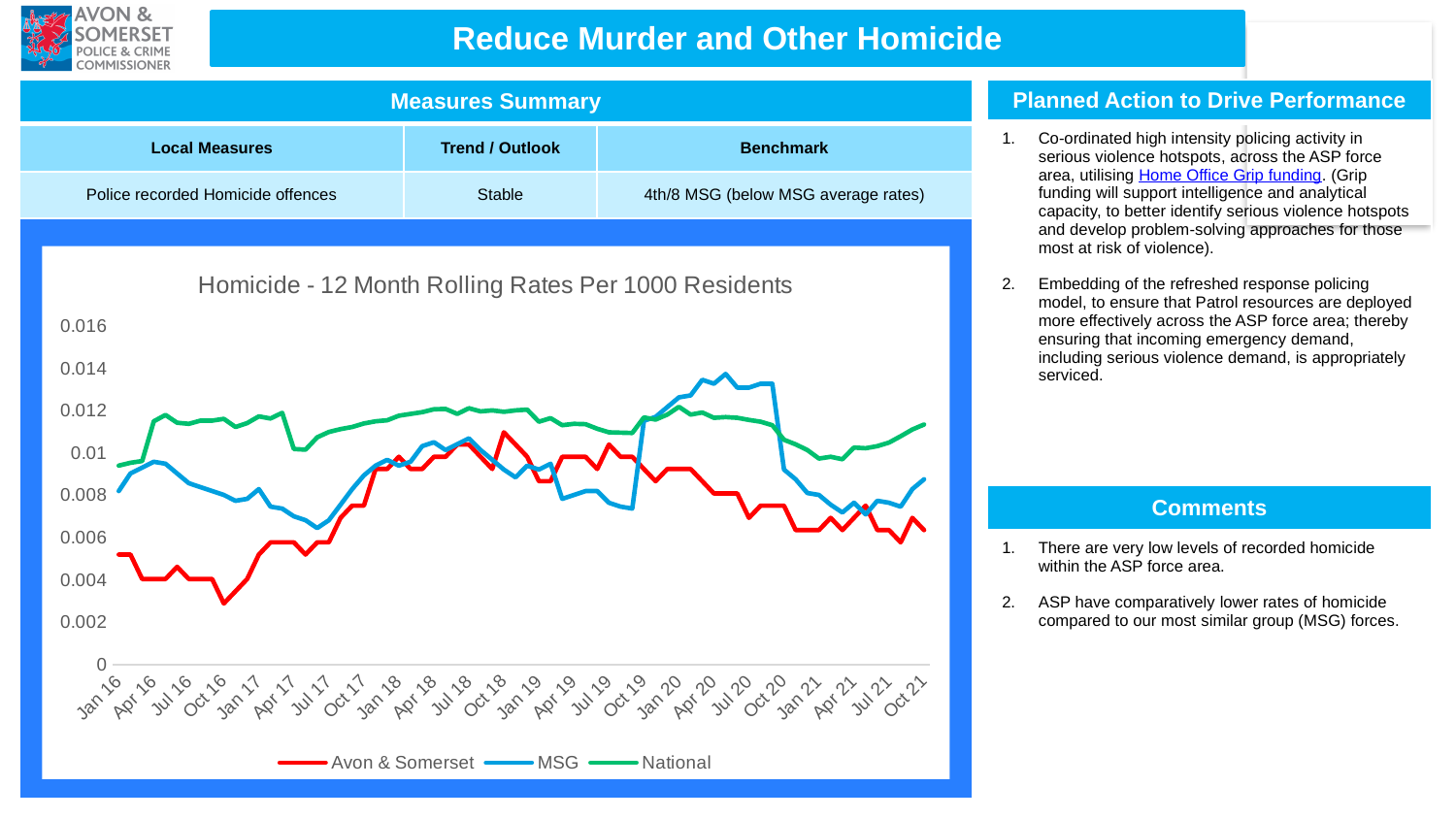
Does the MSG line rise or fall between Oct 19 and Jul 20? rise Which colour is used for the Avon & Somerset line in the chart? red What kind of chart is shown on the slide? line chart What is the title of the chart? Homicide - 12 Month Rolling Rates Per 1000 Residents How many series does the legend of the chart list? 3 Is the Avon & Somerset value at Oct 16 greater or less than 0.004? less Is the National value at Apr 16 greater or less than 0.01? greater At Jul 20, which series has the higher value: MSG or Avon & Somerset? MSG At Jan 16, which series has the higher value: National or Avon & Somerset? National Is the Avon & Somerset value at Jan 16 greater or less than 0.004? greater